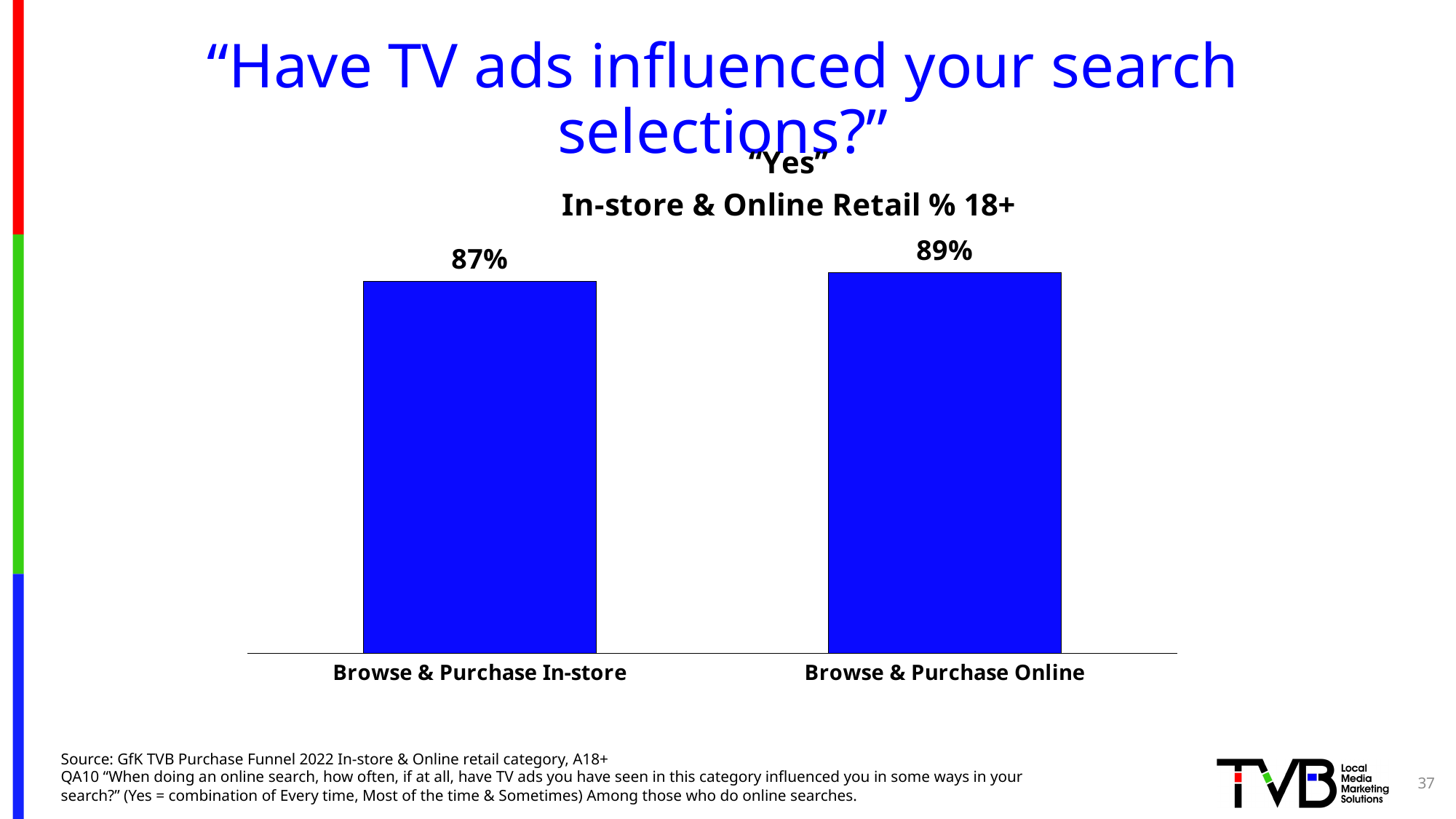
Is the value for Browse & Purchase In-store larger or smaller than the value for Browse & Purchase Online? smaller What percentage of Browse & Purchase Online respondents said "Yes"? 89% What colour are the bars in the chart? blue How many categories are shown in the chart? 2 What is the subtitle of the chart below "Yes"? In-store & Online Retail % 18+ What kind of chart is shown on the slide? bar chart What is the difference in percentage points between Browse & Purchase Online and Browse & Purchase In-store? 2 percentage points What percentage of Browse & Purchase In-store respondents said "Yes"? 87% Which category has the higher "Yes" percentage? Browse & Purchase Online Which category has the lower "Yes" percentage? Browse & Purchase In-store